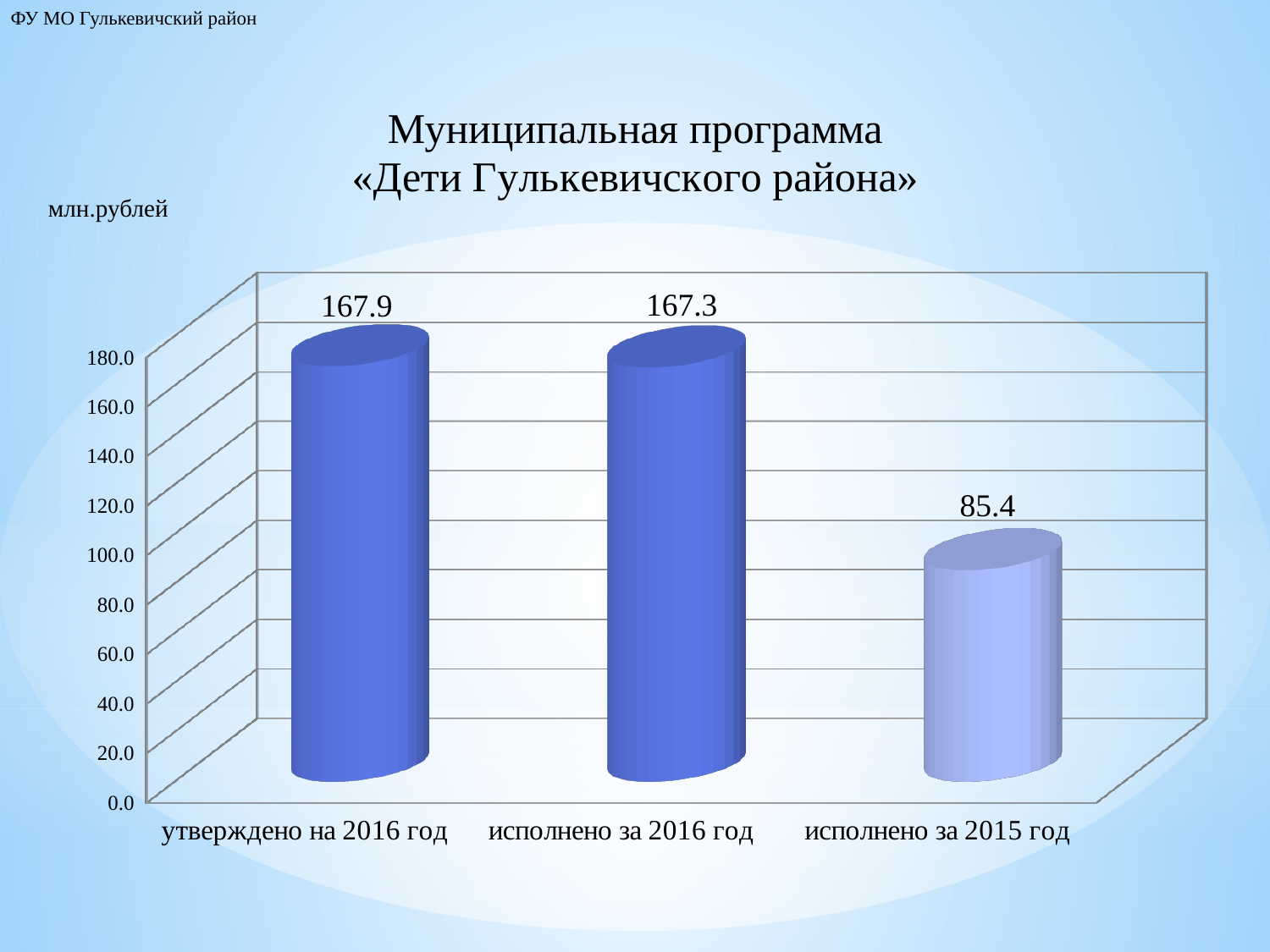
What is the difference between the values for «утверждено на 2016 год» and «исполнено за 2016 год»? 0.6 What is the value for «исполнено за 2015 год»? 85.4 Is the value for «исполнено за 2015 год» greater or less than 100.0? less What is the value for «исполнено за 2016 год»? 167.3 How many categories are shown in the chart? 3 What is the value for «утверждено на 2016 год»? 167.9 What kind of chart is shown on the slide? bar chart What is the title of the chart? Муниципальная программа «Дети Гулькевичского района» Which is larger: the value for «исполнено за 2016 год» or «исполнено за 2015 год»? исполнено за 2016 год Which category has the lowest value? исполнено за 2015 год What is the difference between the values for «исполнено за 2016 год» and «исполнено за 2015 год»? 81.9 What unit is indicated for the values in the chart? млн.рублей